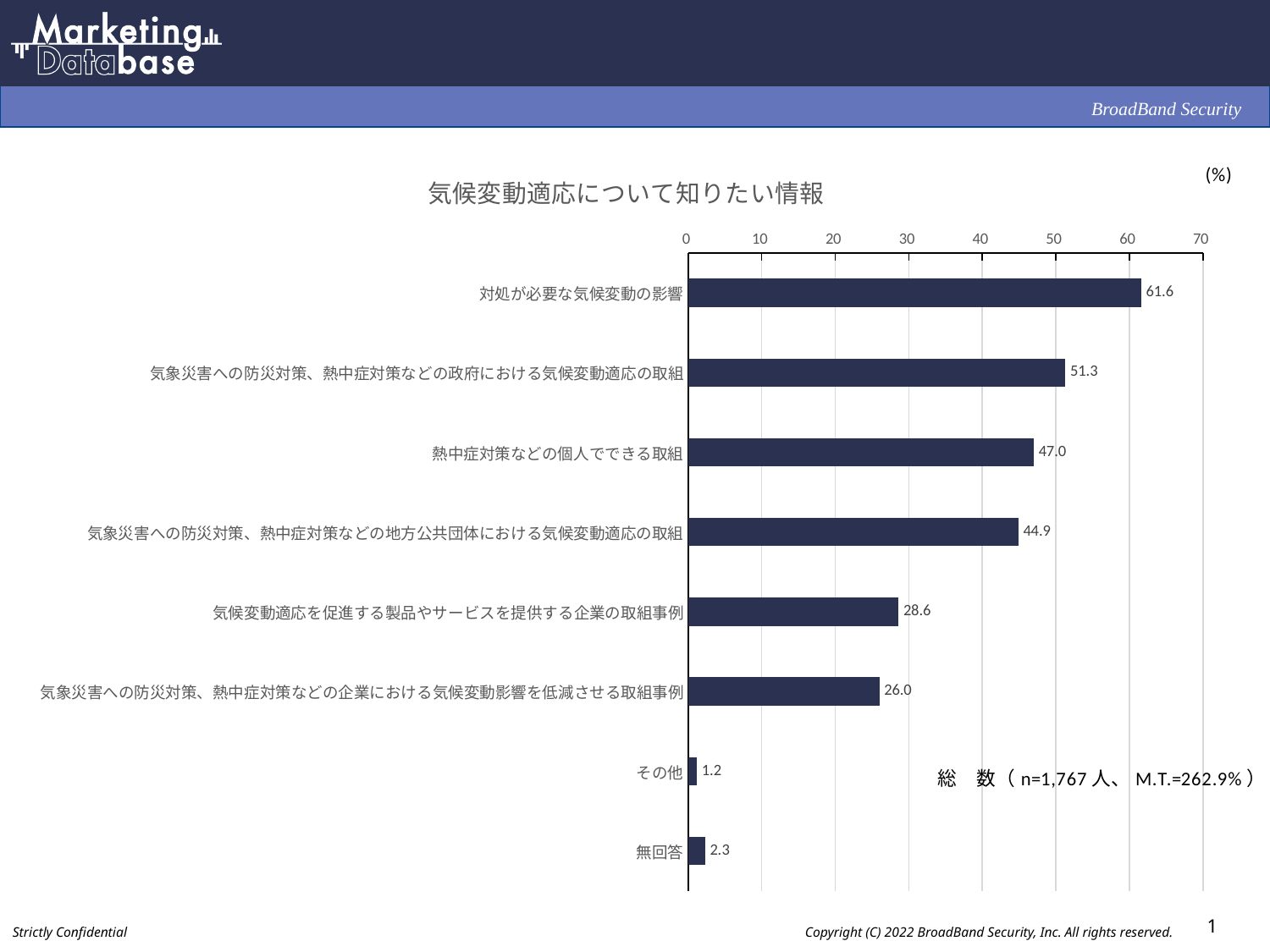
Which category has the lowest value? その他 How many categories are shown in the chart? 8 Which is larger: the value for 気候変動適応を促進する製品やサービスを提供する企業の取組事例 or the value for 気象災害への防災対策、熱中症対策などの企業における気候変動影響を低減させる取組事例? 気候変動適応を促進する製品やサービスを提供する企業の取組事例 Which category has the highest value? 対処が必要な気候変動の影響 What is the value for 無回答? 2.3 What is the value for 対処が必要な気候変動の影響? 61.6 What is the title of the chart? 気候変動適応について知りたい情報 What kind of chart is shown on the slide? bar chart What is the value for 熱中症対策などの個人でできる取組? 47.0 What is the sample size (n) shown on the chart? n=1,767 人 Is the value for 気象災害への防災対策、熱中症対策などの地方公共団体における気候変動適応の取組 greater or less than 40? greater What is the difference between the values for 対処が必要な気候変動の影響 and 気象災害への防災対策、熱中症対策などの政府における気候変動適応の取組? 10.3